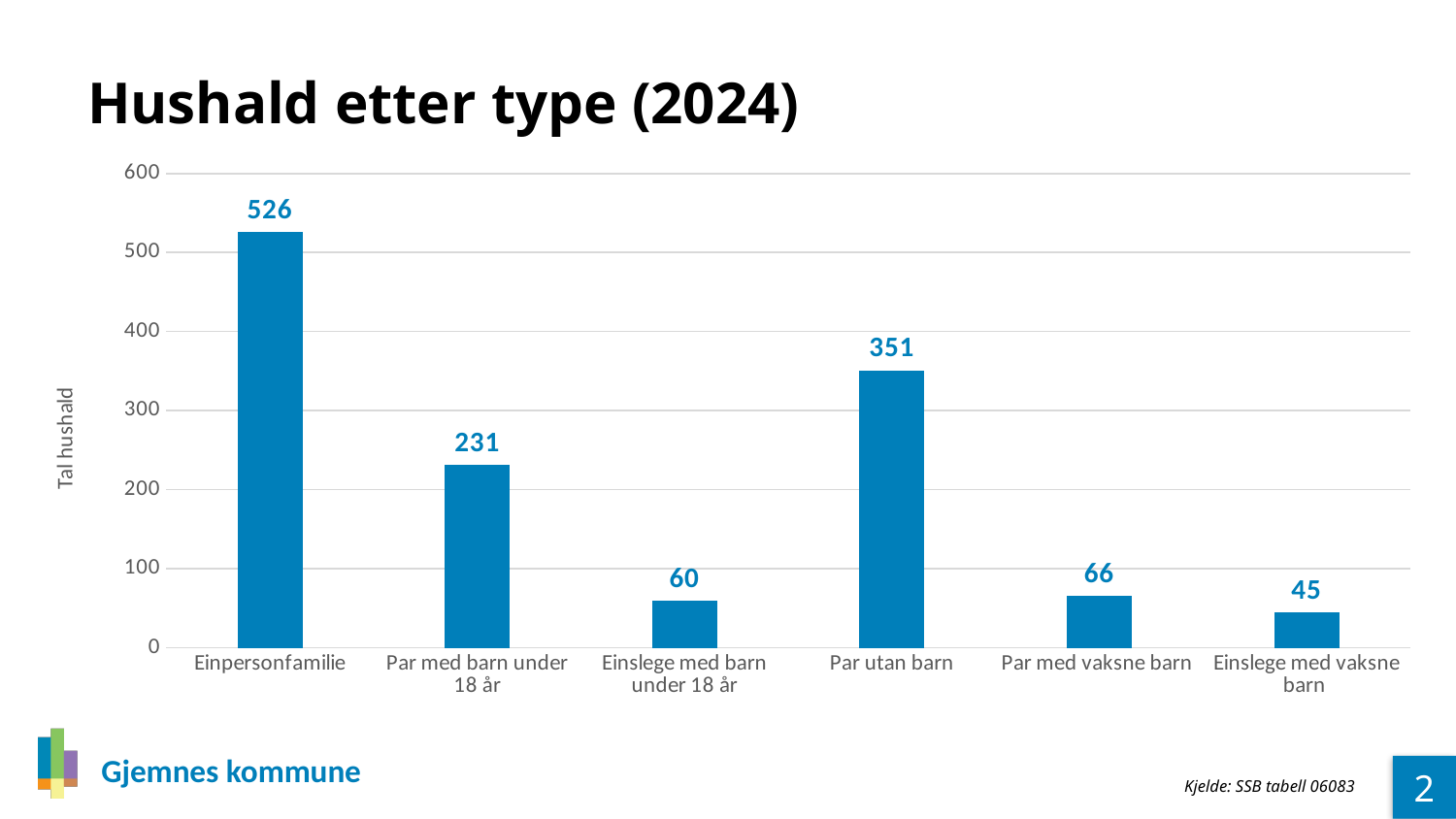
How many household types are shown in the chart? 6 What is the value for Einpersonfamilie? 526 Which is larger, Par med vaksne barn or Einslege med vaksne barn? Par med vaksne barn Which household type has the lowest value? Einslege med vaksne barn Is the value for Par med barn under 18 år greater or less than 200? greater Which household type has the highest value? Einpersonfamilie What is the value for Einslege med vaksne barn? 45 What is the difference between Einpersonfamilie and Par utan barn? 175 What is the value for Par utan barn? 351 What is the difference between Par med barn under 18 år and Einslege med barn under 18 år? 171 What is the title of the chart? Hushald etter type (2024) What kind of chart is shown on the slide? Bar chart